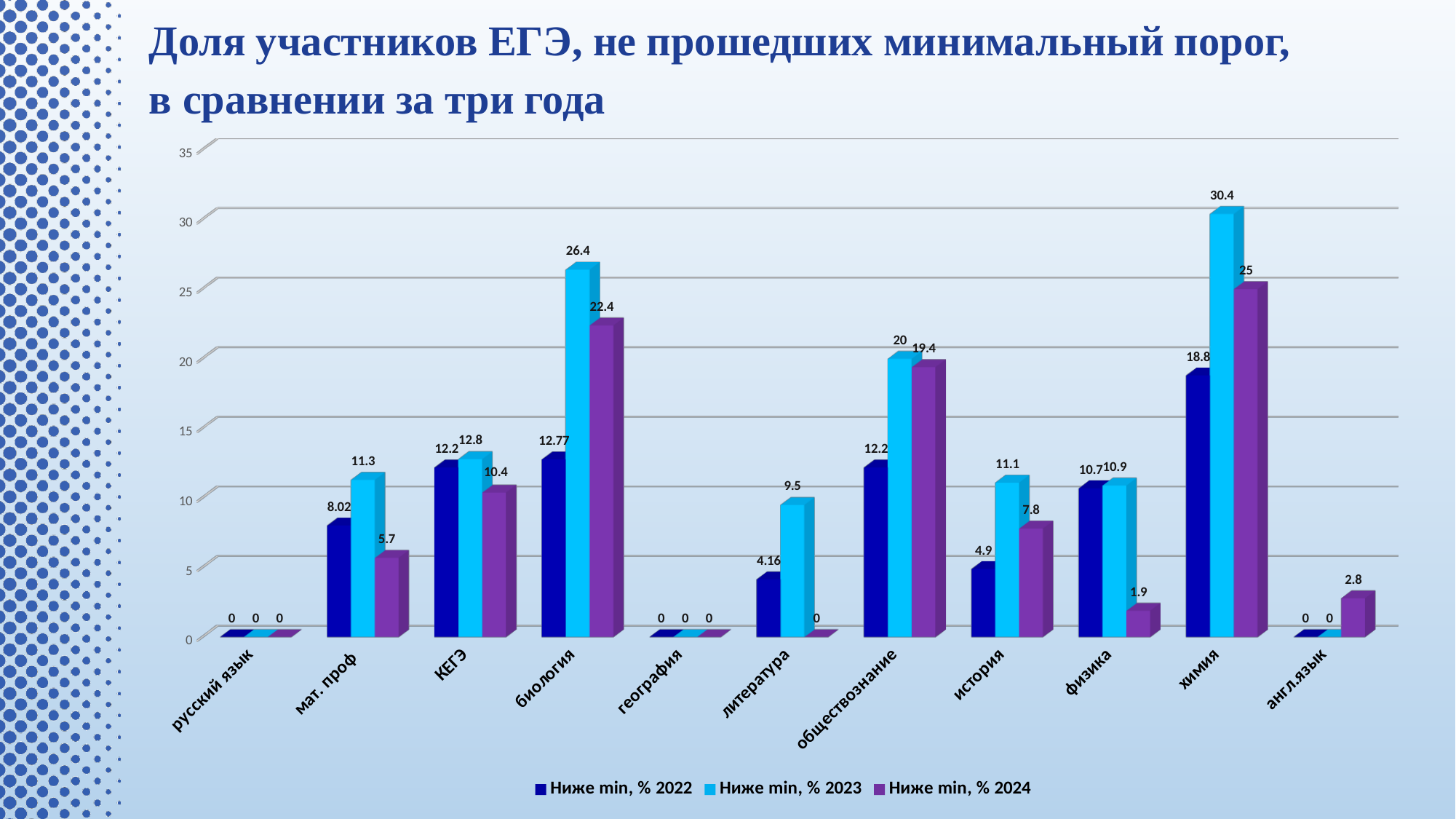
What is the value for литература in the series 'Ниже min, % 2024'? 0 Which is larger for физика: the value for 'Ниже min, % 2022' or 'Ниже min, % 2024'? Ниже min, % 2022 How many series does the legend list? 3 Which subject has the highest value in the series 'Ниже min, % 2024'? химия What is the title of the chart on the slide? Доля участников ЕГЭ, не прошедших минимальный порог, в сравнении за три года What is the difference between the 2023 and 2024 values for биология? 4 What is the value for биология in the series 'Ниже min, % 2022'? 12.77 Which subject has the highest value in the series 'Ниже min, % 2022'? химия Is the value for обществознание in the series 'Ниже min, % 2023' greater or less than 15? greater What type of chart is shown on the slide? Bar chart How many subject categories are shown on the x axis? 11 What is the value for химия in the series 'Ниже min, % 2023'? 30.4